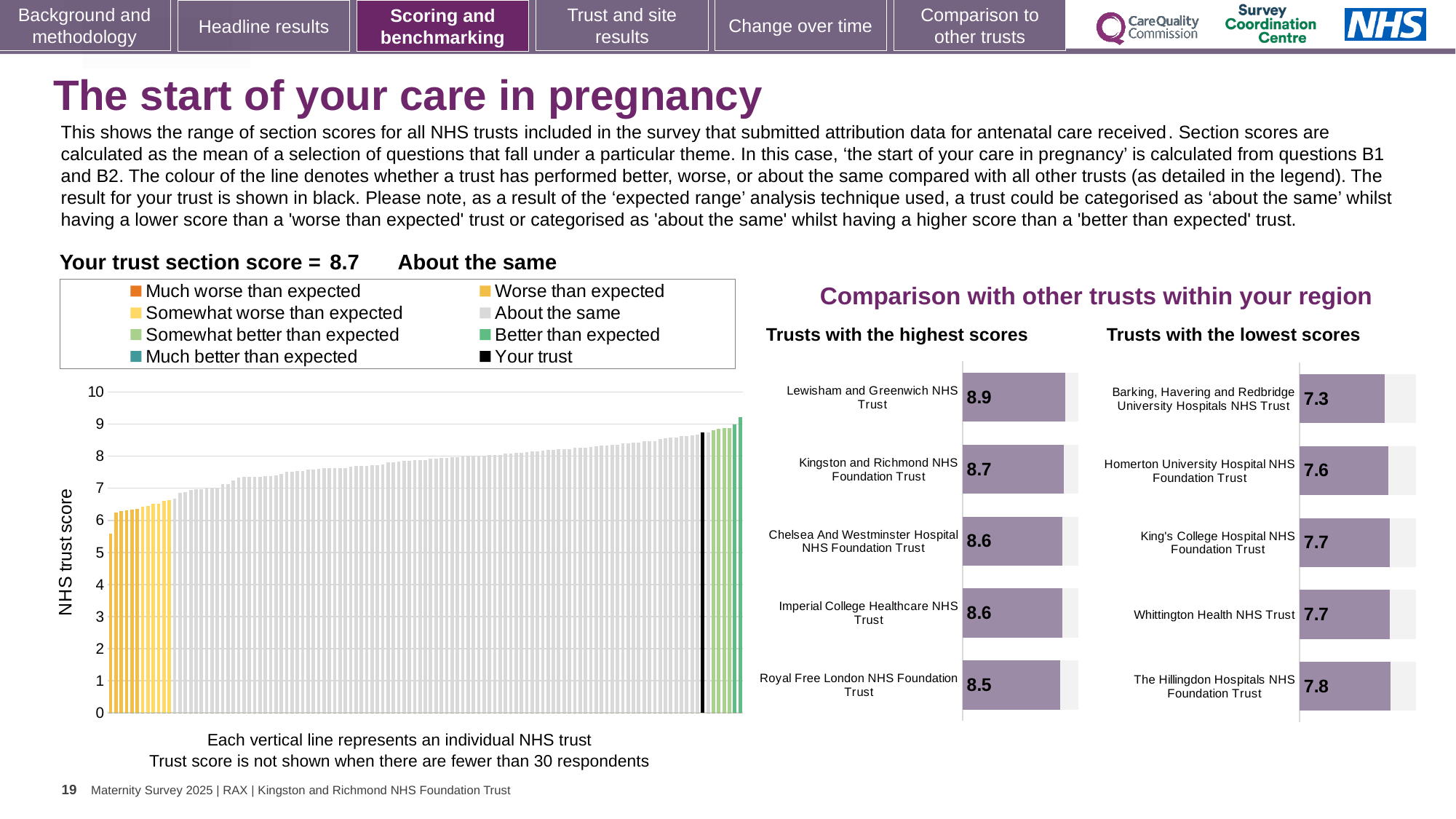
In the 'Trusts with the lowest scores' chart, which has the higher score: Barking, Havering and Redbridge University Hospitals NHS Trust or The Hillingdon Hospitals NHS Foundation Trust? The Hillingdon Hospitals NHS Foundation Trust What is the section score for your trust shown on the slide? 8.7 In the 'Trusts with the lowest scores' chart, which trust has the lowest score? Barking, Havering and Redbridge University Hospitals NHS Trust In the 'NHS trust score' chart, do the values rise or fall from left to right? Rise In the 'Trusts with the highest scores' chart, what is the score for Royal Free London NHS Foundation Trust? 8.5 In the 'Trusts with the lowest scores' chart, what is the score for Homerton University Hospital NHS Foundation Trust? 7.6 In the 'Trusts with the highest scores' chart, what is the difference between the scores of Lewisham and Greenwich NHS Trust and Royal Free London NHS Foundation Trust? 0.4 How many entries does the legend above the 'NHS trust score' chart list? 8 How many trusts are shown in the 'Trusts with the highest scores' chart? 5 What kind of chart is the 'NHS trust score' chart on the left of the slide? Bar chart In the 'Trusts with the highest scores' chart, what is the score for Lewisham and Greenwich NHS Trust? 8.9 In the 'NHS trust score' chart, is the value of the leftmost bar greater or less than 6? less